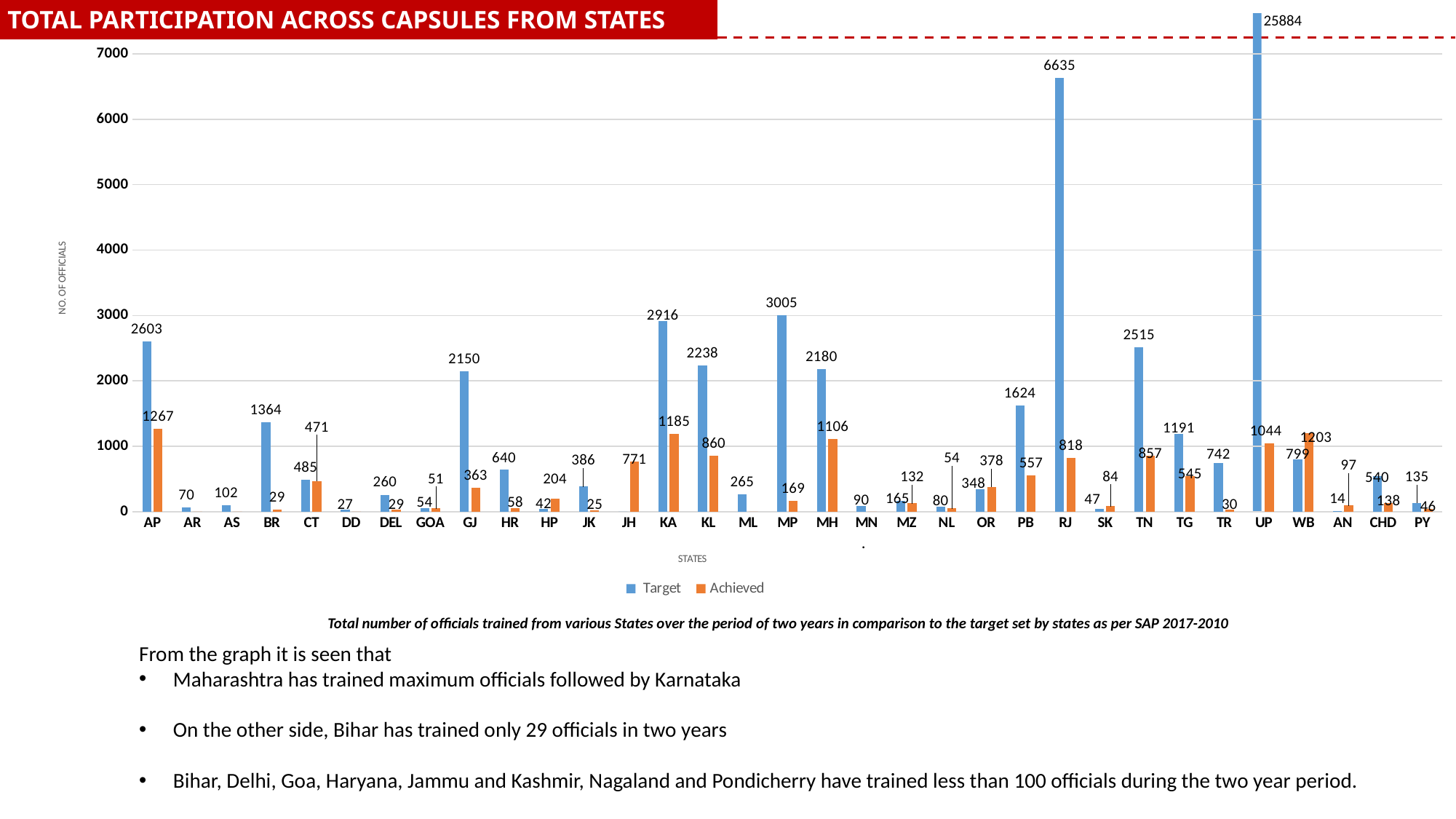
What is the Achieved value for WB? 1203 What is the Target value for KA? 2916 What is the difference between the Target and Achieved values for AP? 1336 How many states are shown on the x axis? 33 What is the Achieved value for BR? 29 What is the title of the chart on the slide? TOTAL PARTICIPATION ACROSS CAPSULES FROM STATES What is the Target value for RJ? 6635 What kind of chart is shown on the slide? Bar chart How many series does the legend list? 2 Which is larger for MP, the Target value or the Achieved value? Target Is the Target value for TN greater or less than 2000? greater Which state has the highest Target value? UP